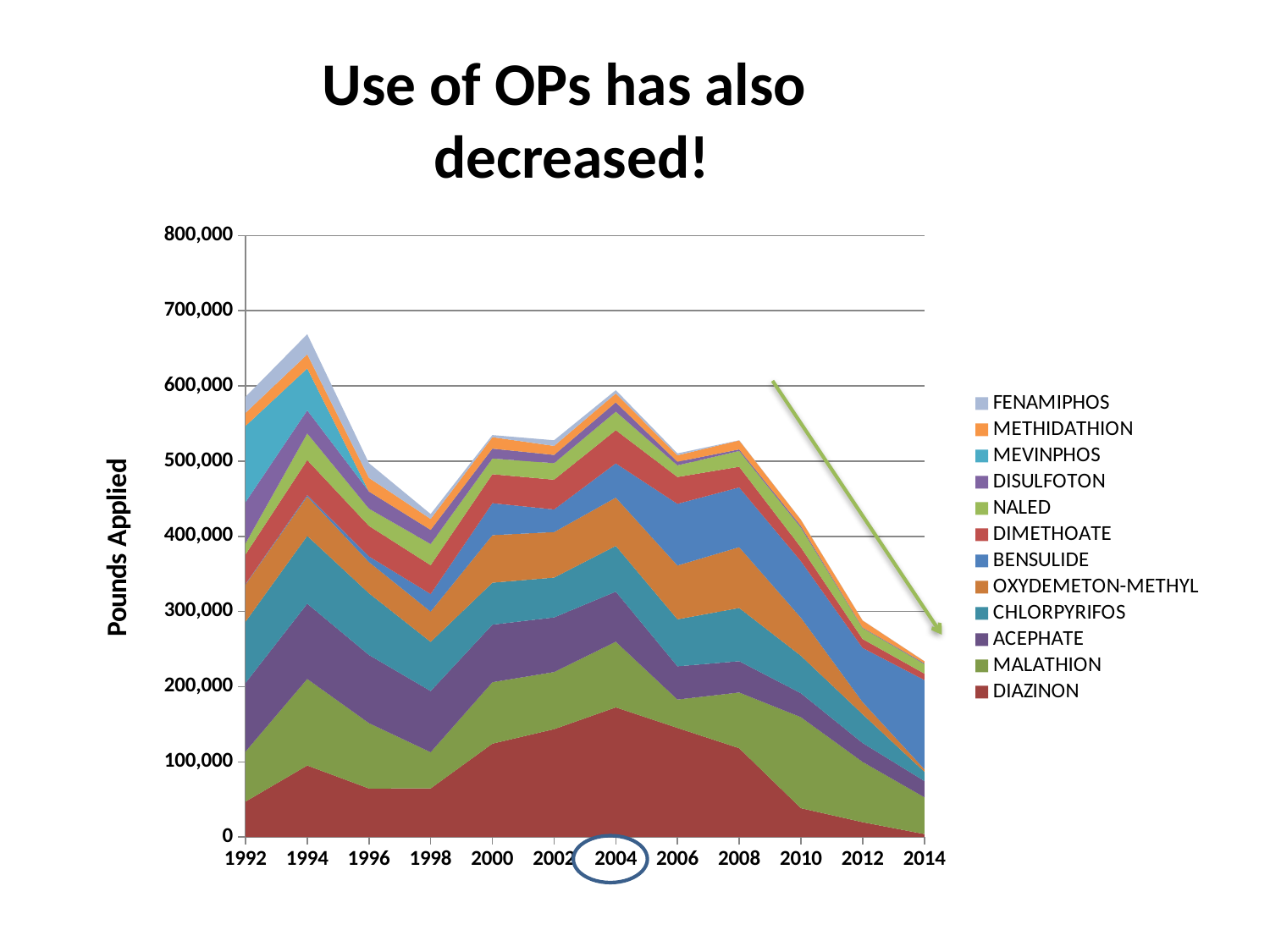
Which year has a larger total pounds applied, 1992 or 2014? 1992 How many years are labelled along the x axis? 12 Overall, do the total pounds applied rise or fall from 2004 to 2014? fall Is the total pounds applied in 2014 greater or less than 300,000? less Is the total pounds applied in 1994 greater or less than 600,000? greater Is the total pounds applied in 1998 greater or less than 500,000? less In which year is the total pounds applied lowest? 2014 What kind of chart is shown on the slide? Stacked area chart How many series does the legend list? 12 What is the label on the y axis? Pounds Applied In which year is the total pounds applied highest? 1994